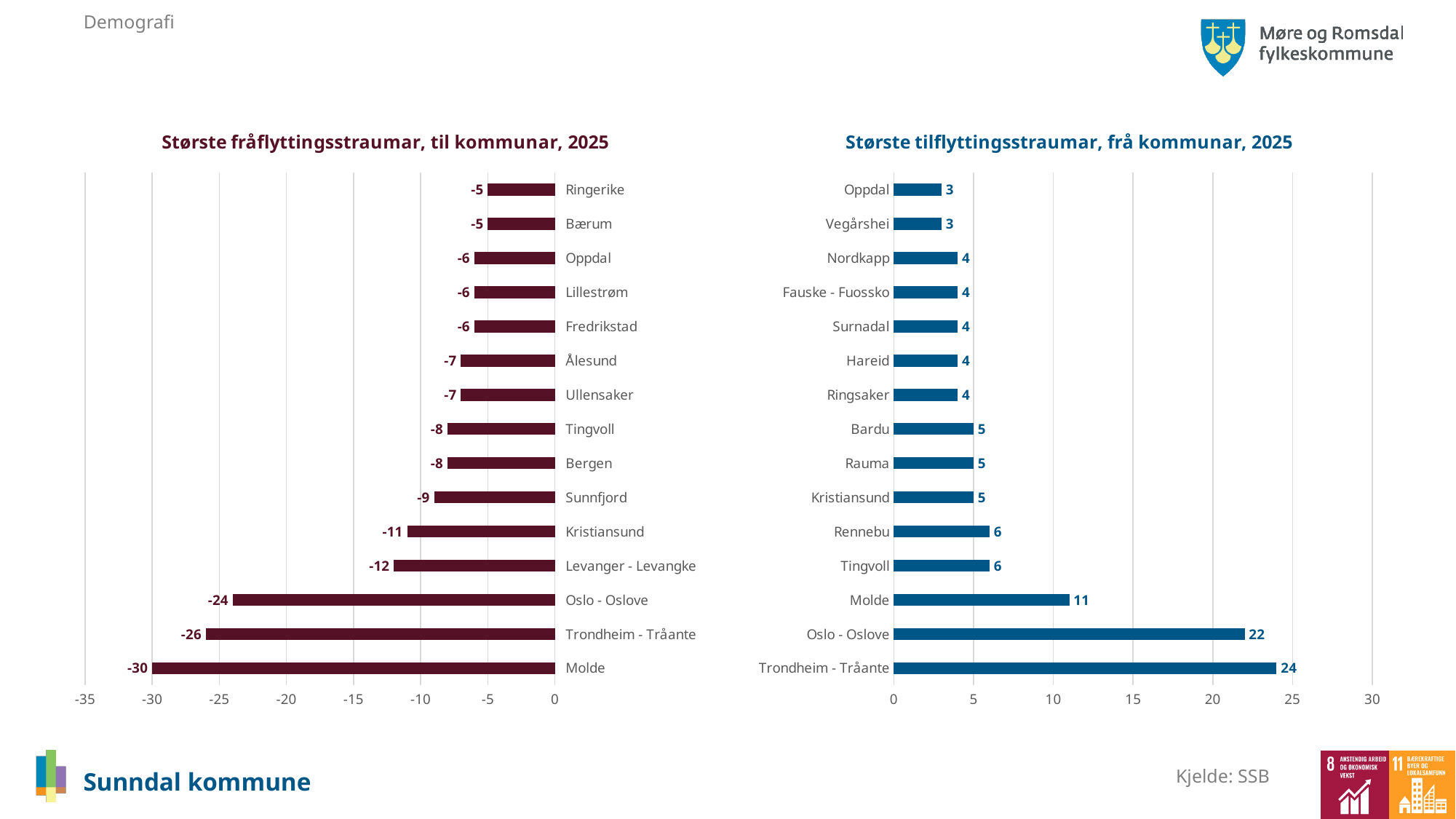
In the chart 'Største tilflyttingsstraumar, frå kommunar, 2025', which municipality has the highest value? Trondheim - Tråante In the chart 'Største tilflyttingsstraumar, frå kommunar, 2025', what is the value for Oslo - Oslove? 22 In the chart 'Største tilflyttingsstraumar, frå kommunar, 2025', what is the value for Rennebu? 6 How many municipalities are shown in the chart 'Største fråflyttingsstraumar, til kommunar, 2025'? 15 What type of chart is 'Største tilflyttingsstraumar, frå kommunar, 2025'? Bar chart In the chart 'Største fråflyttingsstraumar, til kommunar, 2025', what is the value for Molde? -30 In the chart 'Største fråflyttingsstraumar, til kommunar, 2025', what is the difference between the values for Oslo - Oslove and Levanger - Levangke? 12 In the chart 'Største fråflyttingsstraumar, til kommunar, 2025', which municipality has the lowest (most negative) value? Molde In the chart 'Største tilflyttingsstraumar, frå kommunar, 2025', which has a larger value, Molde or Tingvoll? Molde In the chart 'Største tilflyttingsstraumar, frå kommunar, 2025', what is the difference between the values for Trondheim - Tråante and Molde? 13 In the chart 'Største fråflyttingsstraumar, til kommunar, 2025', what is the value for Kristiansund? -11 What is the title of the left chart on the slide? Største fråflyttingsstraumar, til kommunar, 2025